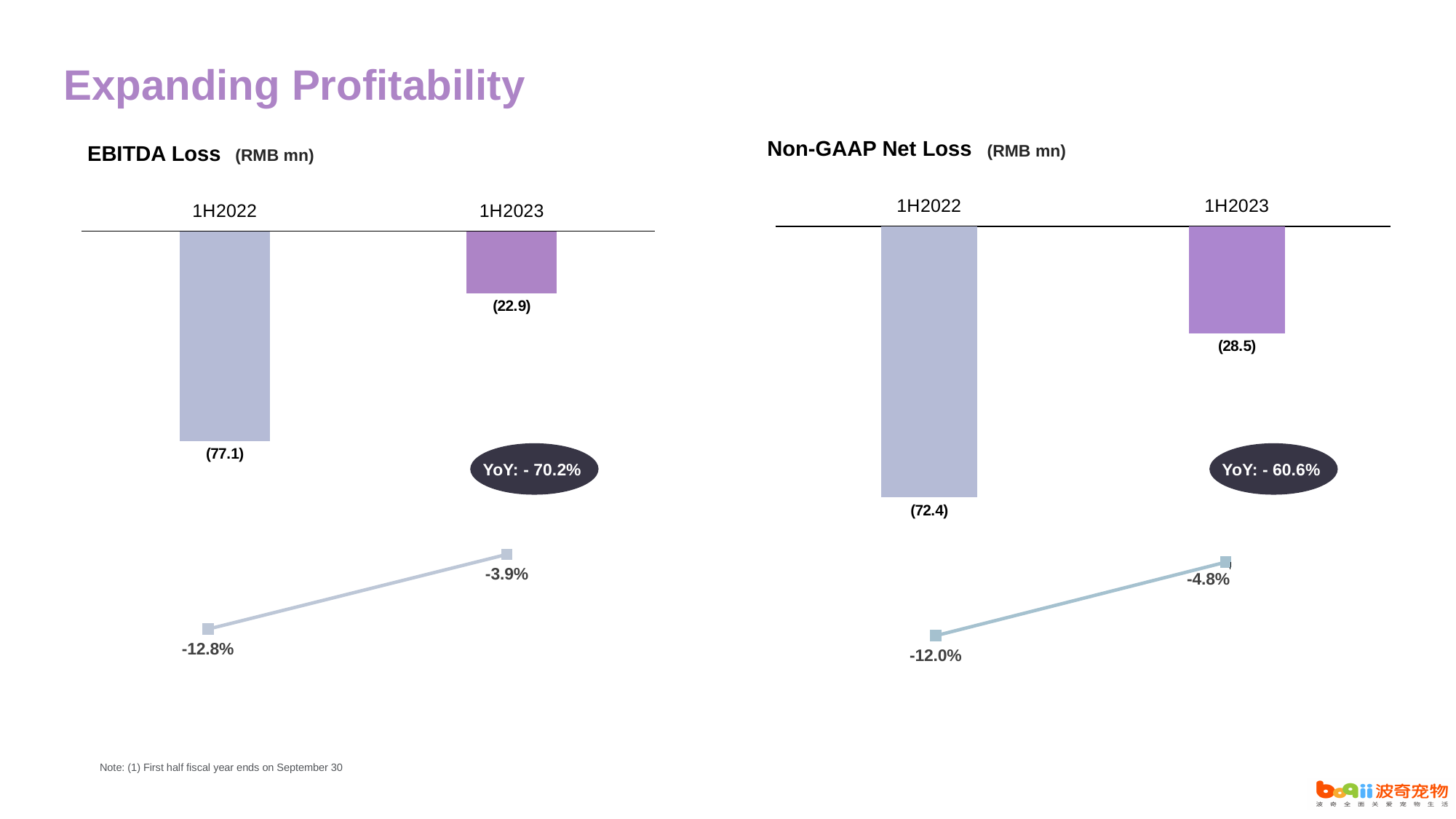
In the EBITDA Loss chart, what is the value for 1H2023? (22.9) In the EBITDA Loss chart, what YoY change is shown in the oval label? - 70.2% In the EBITDA Loss chart, what is the difference between the 1H2022 loss and the 1H2023 loss? 54.2 In the Non-GAAP Net Loss chart, what is the value for 1H2023? (28.5) How many periods are plotted in the Non-GAAP Net Loss chart? 2 In the Non-GAAP Net Loss chart, what is the difference between the 1H2022 loss and the 1H2023 loss? 43.9 In the Non-GAAP Net Loss chart, what is the value for 1H2022? (72.4) In the EBITDA Loss chart, which period has the larger loss bar? 1H2022 In the EBITDA Loss chart, what is the value for 1H2022? (77.1) In the Non-GAAP Net Loss chart, which period has the smaller loss bar? 1H2023 In the EBITDA Loss chart, what is the margin percentage shown for 1H2023 on the line? -3.9% In the Non-GAAP Net Loss chart, what is the margin percentage shown for 1H2022 on the line? -12.0%